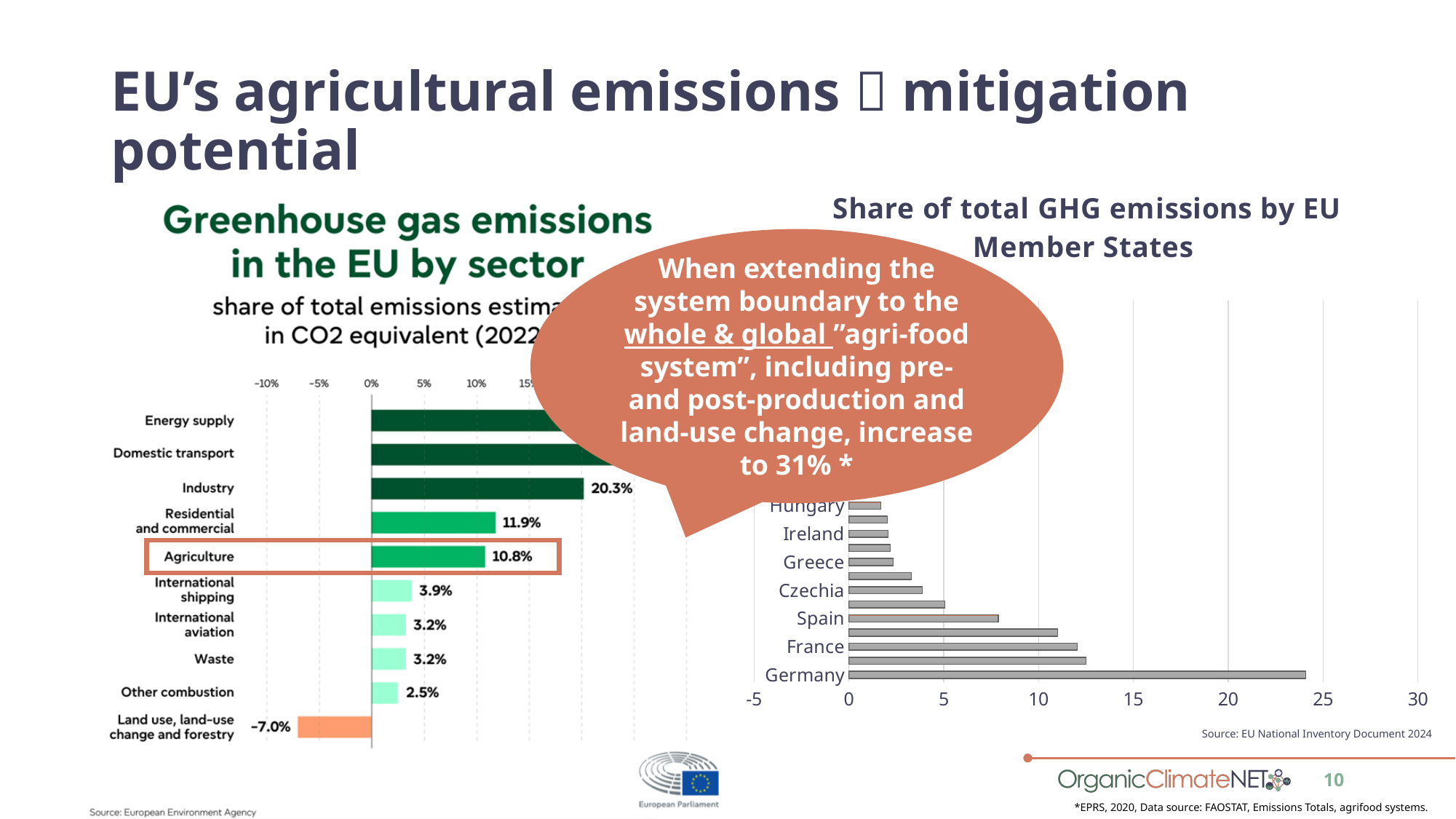
How many sectors are listed in the 'Greenhouse gas emissions in the EU by sector' chart? 10 In the 'Share of total GHG emissions by EU Member States' chart, which country has the highest share? Germany In the 'Greenhouse gas emissions in the EU by sector' chart, which is larger: Residential and commercial or Agriculture? Residential and commercial In the 'Greenhouse gas emissions in the EU by sector' chart, what is the share for Industry? 20.3% In the 'Greenhouse gas emissions in the EU by sector' chart, what is the value for Land use, land-use change and forestry? -7.0% In the 'Greenhouse gas emissions in the EU by sector' chart, what is the share for Agriculture? 10.8% In the 'Greenhouse gas emissions in the EU by sector' chart, which sector has the lowest value? Land use, land-use change and forestry In the 'Greenhouse gas emissions in the EU by sector' chart, what is the share for Residential and commercial? 11.9% In the 'Greenhouse gas emissions in the EU by sector' chart, what is the share for International shipping? 3.9% In the 'Share of total GHG emissions by EU Member States' chart, is the value for Germany greater or less than 20? greater In the 'Greenhouse gas emissions in the EU by sector' chart, what is the difference between the Industry share and the Agriculture share? 9.5% What kind of chart is 'Share of total GHG emissions by EU Member States'? Bar chart